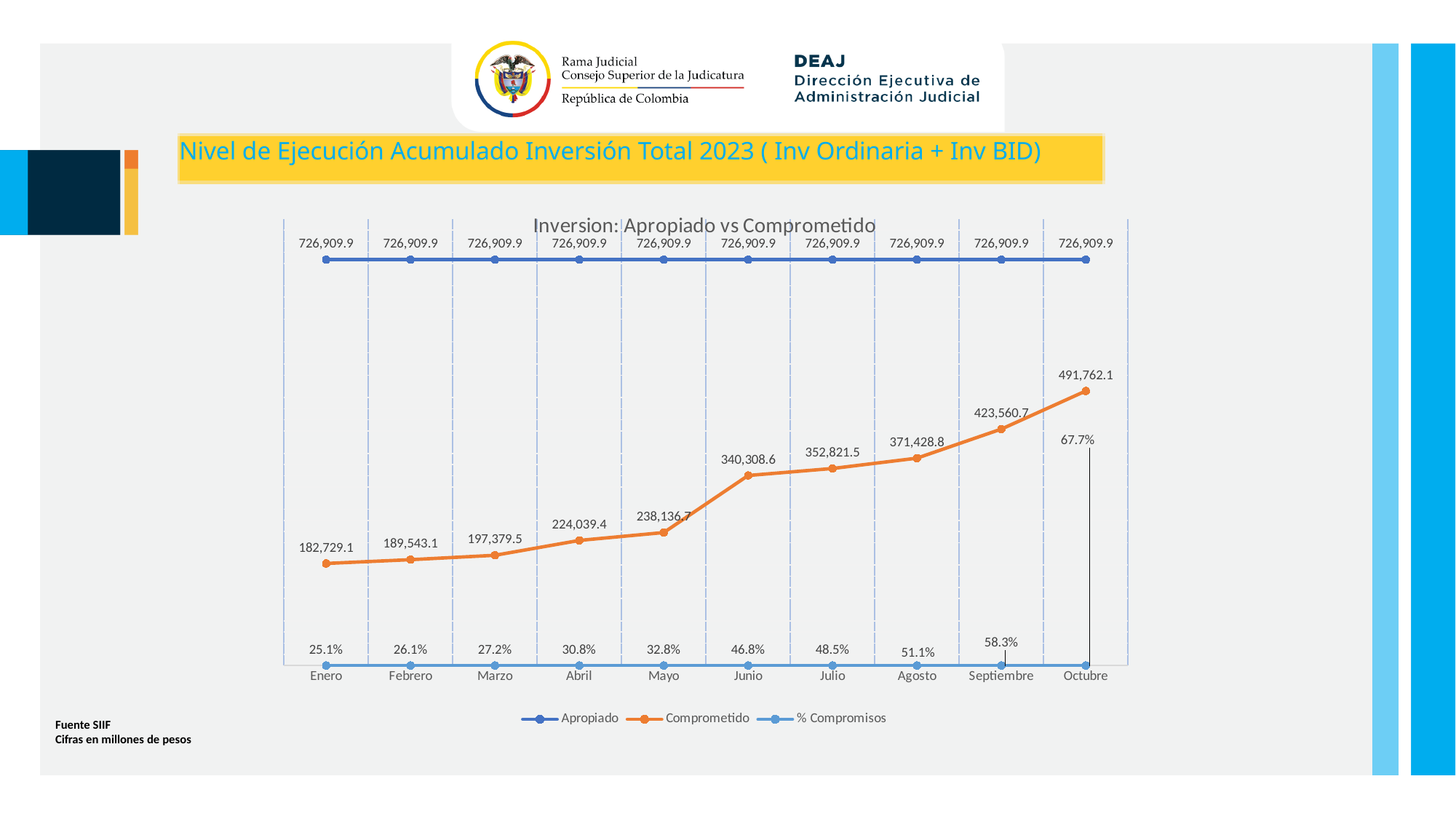
What is the difference between the Comprometido values for Octubre and Septiembre? 68,201.4 How many months are shown on the x axis? 10 Which is larger, the Comprometido value for Junio or for Julio? Julio How many series does the legend list? 3 What is the Comprometido value for Octubre? 491,762.1 What is the Apropiado value for Enero? 726,909.9 Does the Comprometido series rise or fall from Enero to Octubre? rise In which month is the Comprometido value lowest? Enero What is the Comprometido value for Mayo? 238,136.7 What is the % Compromisos value for Junio? 46.8% What kind of chart is shown? line chart In which month is the Comprometido value highest? Octubre